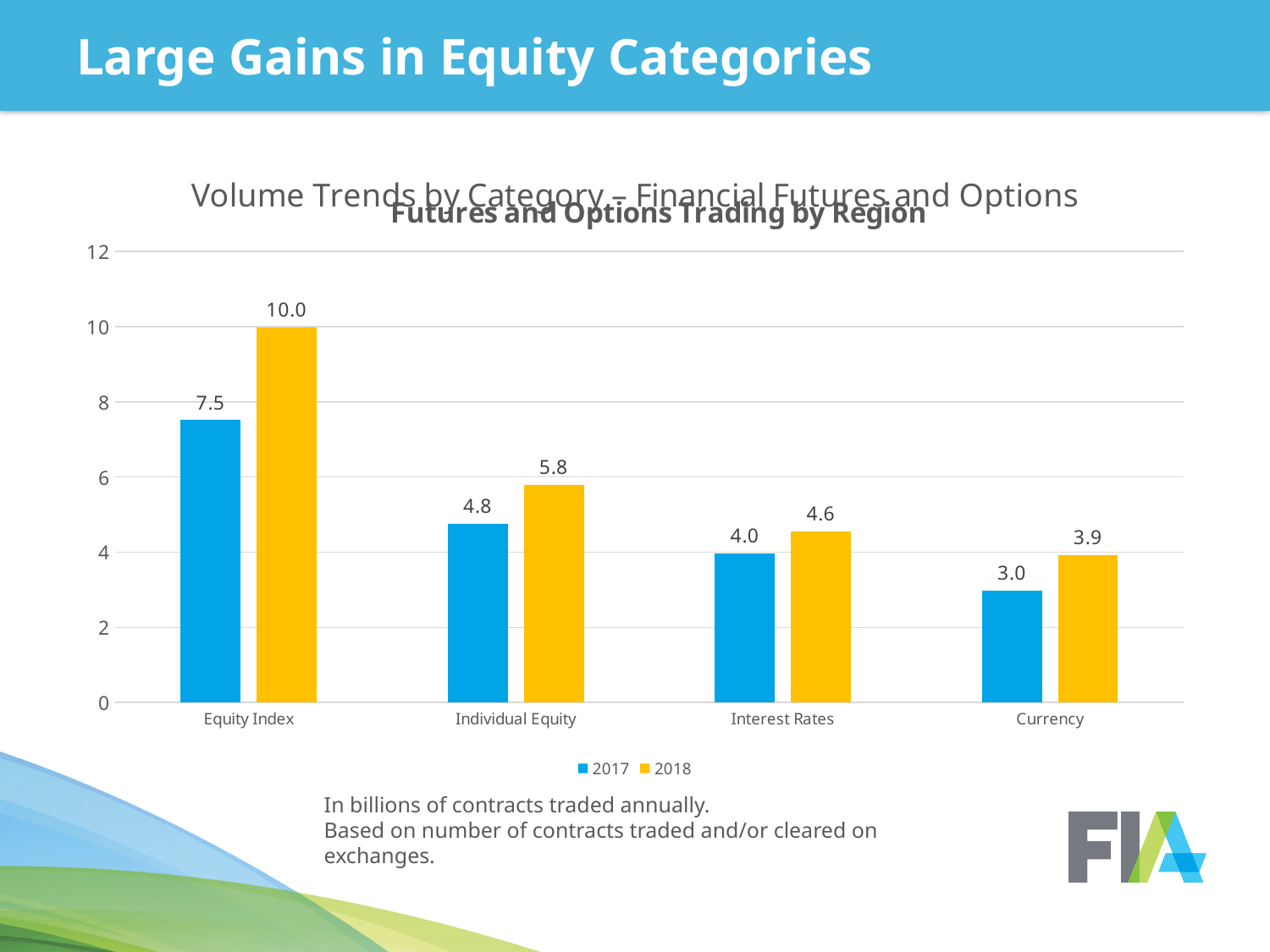
What is the difference between the 2018 and 2017 values for Interest Rates? 0.6 Which colour represents the 2018 series in the chart? Yellow What is the difference between the 2018 and 2017 values for Equity Index? 2.5 How many categories are shown on the x axis? 4 How many series does the legend list? 2 Which category had the lowest 2017 value? Currency Which category had the highest 2018 value? Equity Index What kind of chart is shown on the slide? Bar chart Which is larger: the 2018 value for Individual Equity or the 2018 value for Interest Rates? Individual Equity What was the 2017 value for Individual Equity? 4.8 What was the 2017 value for Currency? 3.0 What was the 2018 value for Equity Index? 10.0